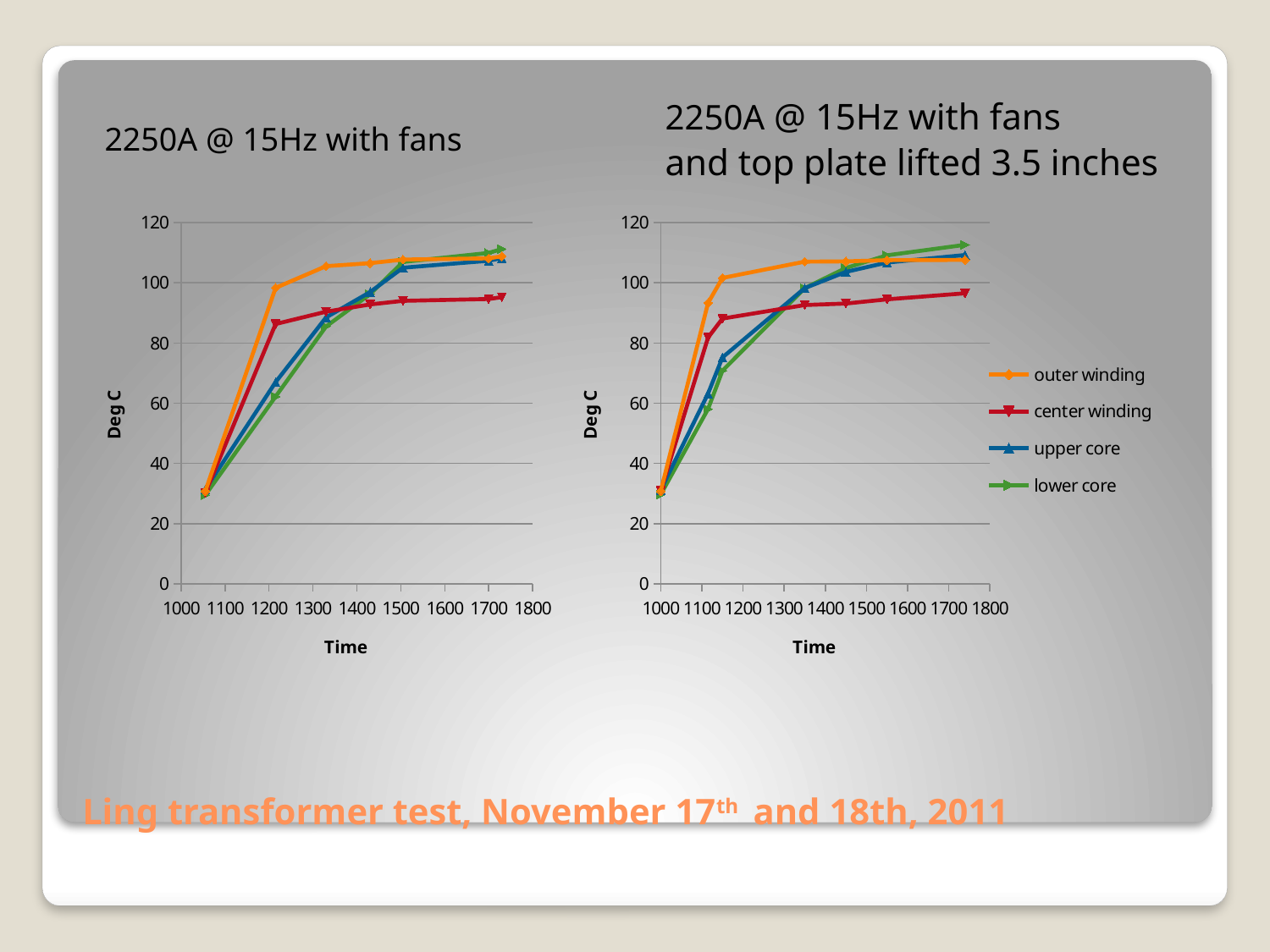
What kind of chart is the left chart titled "2250A @ 15Hz with fans"? line chart In the right chart ("2250A @ 15Hz with fans and top plate lifted 3.5 inches"), do the values for outer winding rise or fall along the x axis? rise In the left chart ("2250A @ 15Hz with fans"), do the temperature values rise or fall as time increases along the x axis? rise In the left chart ("2250A @ 15Hz with fans"), at the last time point, which is higher: outer winding or center winding? outer winding In the left chart ("2250A @ 15Hz with fans"), is the first plotted value for outer winding greater or less than 40? less In the left chart ("2250A @ 15Hz with fans"), at the last time point, which series has the lowest value? center winding In the right chart ("2250A @ 15Hz with fans and top plate lifted 3.5 inches"), is the final value for lower core greater or less than 100? greater How many series does the legend list for the charts on the slide? 4 What is the label on the y axis of the charts on the slide? Deg C What is the title of the right chart on the slide? 2250A @ 15Hz with fans and top plate lifted 3.5 inches In the left chart ("2250A @ 15Hz with fans"), is the final value for center winding greater or less than 80? greater In the right chart ("2250A @ 15Hz with fans and top plate lifted 3.5 inches"), at the last time point, which series has the lowest value? center winding